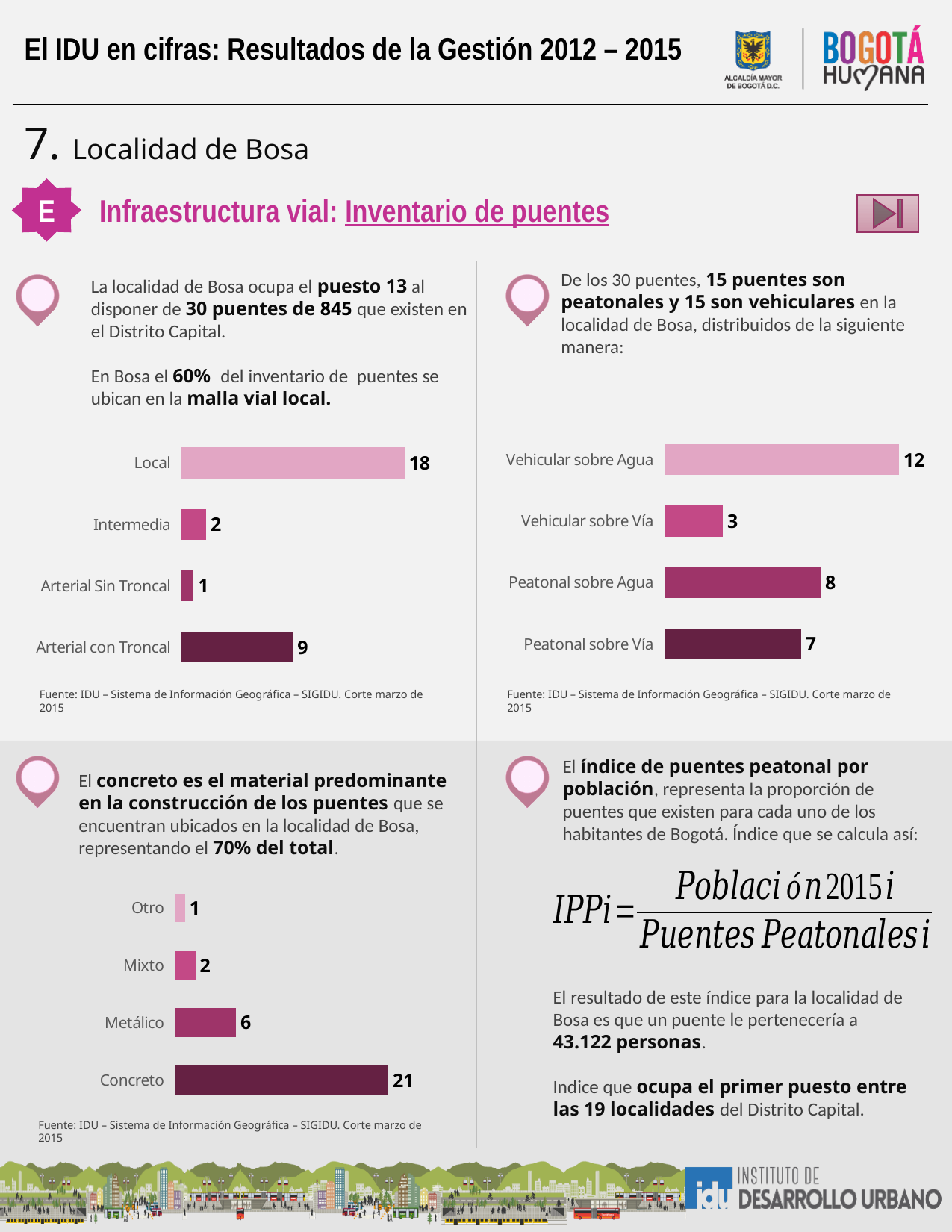
In the top-right chart, which is larger, Vehicular sobre Vía or Peatonal sobre Vía? Peatonal sobre Vía How many categories does the top-left chart show? 4 In the top-right chart, what is the value for Peatonal sobre Agua? 8 In the bottom-left chart, what is the value for Metálico? 6 What type of chart is the bottom-left chart? Bar chart In the top-left chart, which category has the lowest value? Arterial Sin Troncal In the bottom-left chart, what is the difference between Concreto and Mixto? 19 In the top-left chart, what is the difference between the values for Local and Arterial con Troncal? 9 In the bottom-left chart, which category has the highest value? Concreto In the top-right chart, what is the difference between Vehicular sobre Agua and Vehicular sobre Vía? 9 In the top-left chart, what is the value for Local? 18 In the top-right chart, which category has the highest value? Vehicular sobre Agua